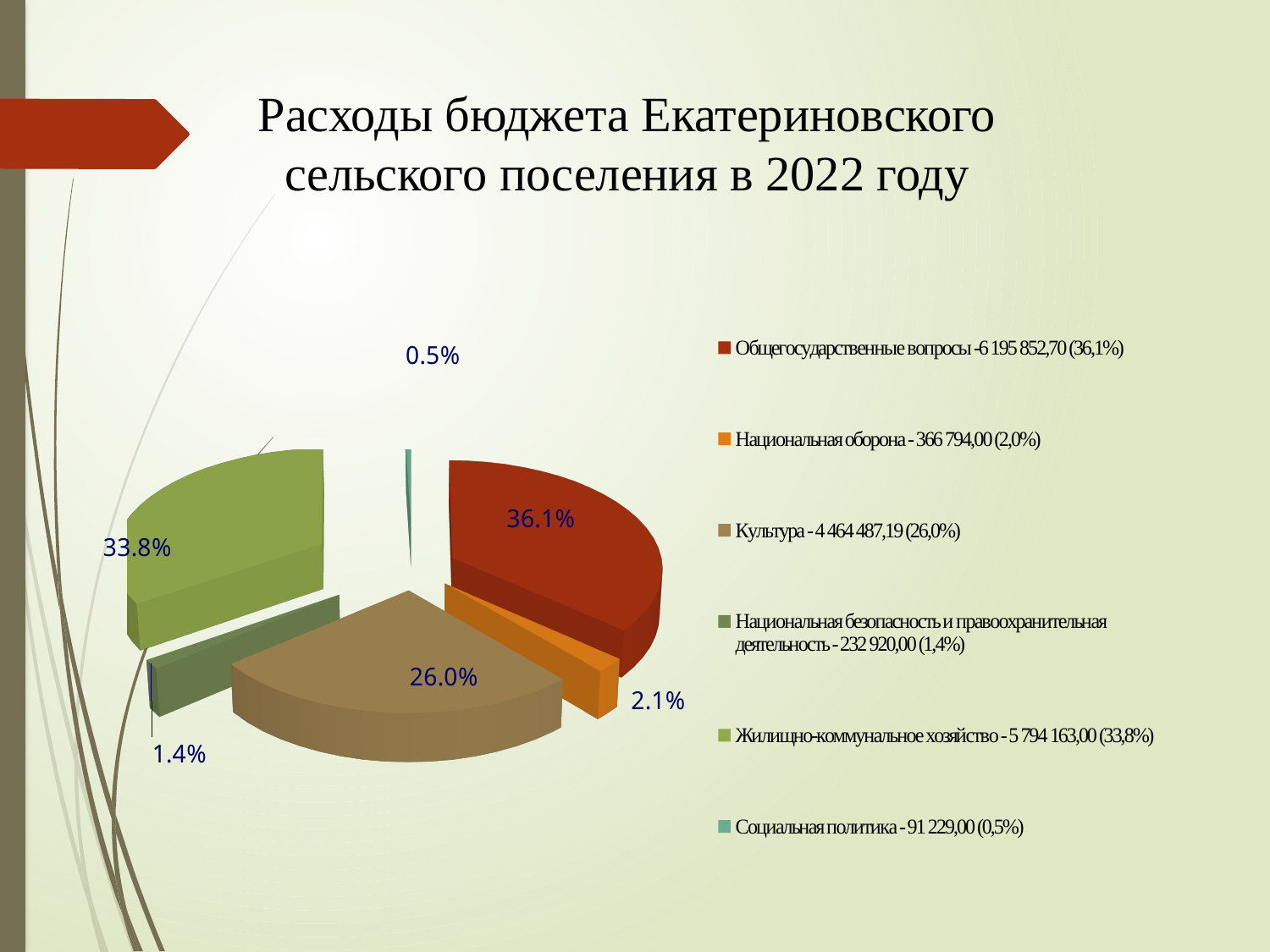
What share of the pie is labelled for the Жилищно-коммунальное хозяйство slice? 33.8% Which category has the largest share of the pie? Общегосударственные вопросы How many categories does the legend of the pie chart list? 6 What is the difference between the labelled shares of Общегосударственные вопросы (36.1%) and Жилищно-коммунальное хозяйство (33.8%)? 2.3% What is the title of the slide containing the pie chart? Расходы бюджета Екатериновского сельского поселения в 2022 году What share of the pie is labelled for the red slice (Общегосударственные вопросы)? 36.1% What kind of chart is shown on the slide? pie chart Which is larger: the share for Культура or the share for Жилищно-коммунальное хозяйство? Жилищно-коммунальное хозяйство What share of the pie is labelled for the Культура slice? 26.0% According to the legend, what is the amount for Национальная оборона? 366 794,00 Which category has the smallest share of the pie? Социальная политика